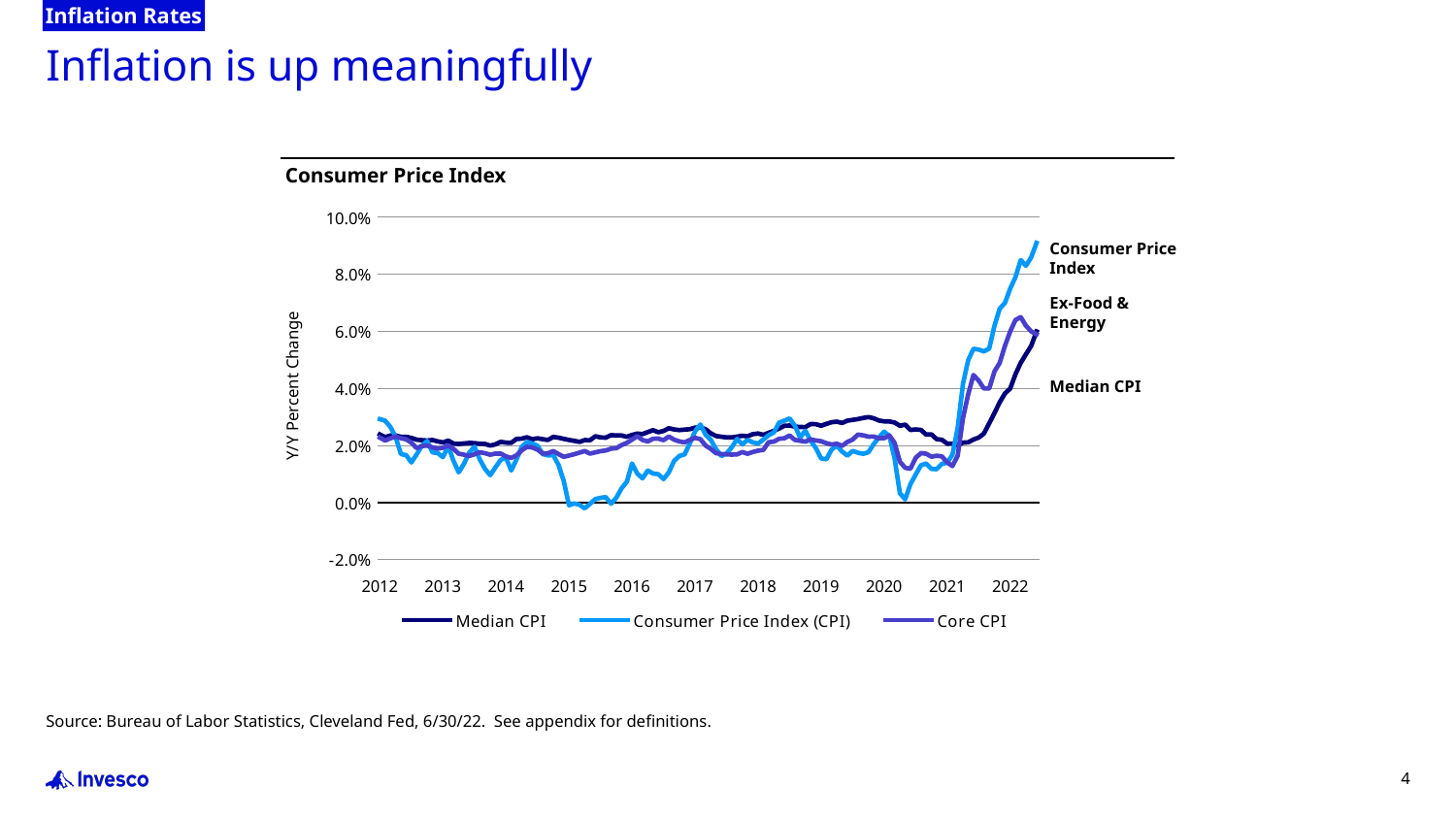
How many series does the legend of the Consumer Price Index chart list? 3 Is the value of the Median CPI line at the end of 2022 greater or less than 4.0%? greater What is the label on the y axis of the chart? Y/Y Percent Change Is the value of the Core CPI line at the end of 2022 greater or less than 4.0%? greater Is the value of the Consumer Price Index (CPI) line in 2015 greater or less than 2.0%? less What kind of chart is shown on the slide? Line chart What is the title of the chart? Consumer Price Index Does the Consumer Price Index (CPI) line rise or fall from 2020 to 2022? Rise At the end of 2022, which is higher: the Consumer Price Index (CPI) line or the Median CPI line? Consumer Price Index (CPI) Which series reaches the lowest value on the chart? Consumer Price Index (CPI) Which series reaches the highest value on the chart? Consumer Price Index (CPI)